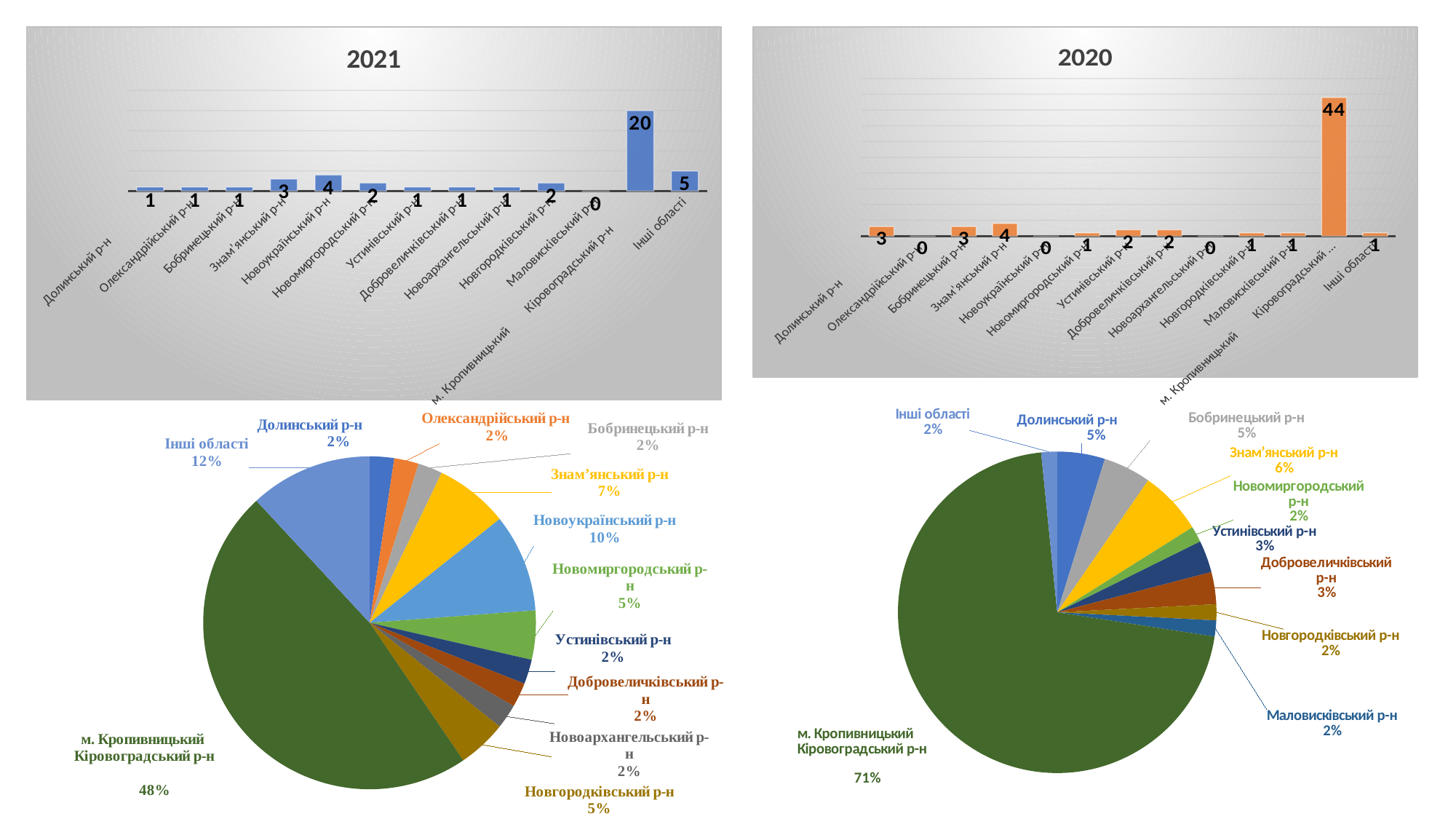
In the bottom-right pie chart, what share does м. Кропивницький Кіровоградський р-н have? 71% In the bar chart titled 2020, what is the value for Олександрійський р-н? 0 In the bar chart titled 2020, which is larger, the value for Знам'янський р-н or the value for Долинський р-н? Знам'янський р-н In the bar chart titled 2021, what is the value for Інші області? 5 In the bar chart titled 2020, which category has the highest value? м. Кропивницький Кіровоградський р-н In the bar chart titled 2020, what is the value for м. Кропивницький Кіровоградський р-н? 44 In the bar chart titled 2021, what is the difference between the values for м. Кропивницький Кіровоградський р-н and Інші області? 15 In the bar chart titled 2021, what is the value for Новоукраїнський р-н? 4 What kind of chart is the chart titled 2021? bar chart In the bottom-left pie chart, what share does м. Кропивницький Кіровоградський р-н have? 48% In the bar chart titled 2021, what is the value for м. Кропивницький Кіровоградський р-н? 20 In the bottom-left pie chart, what share does Новоукраїнський р-н have? 10%